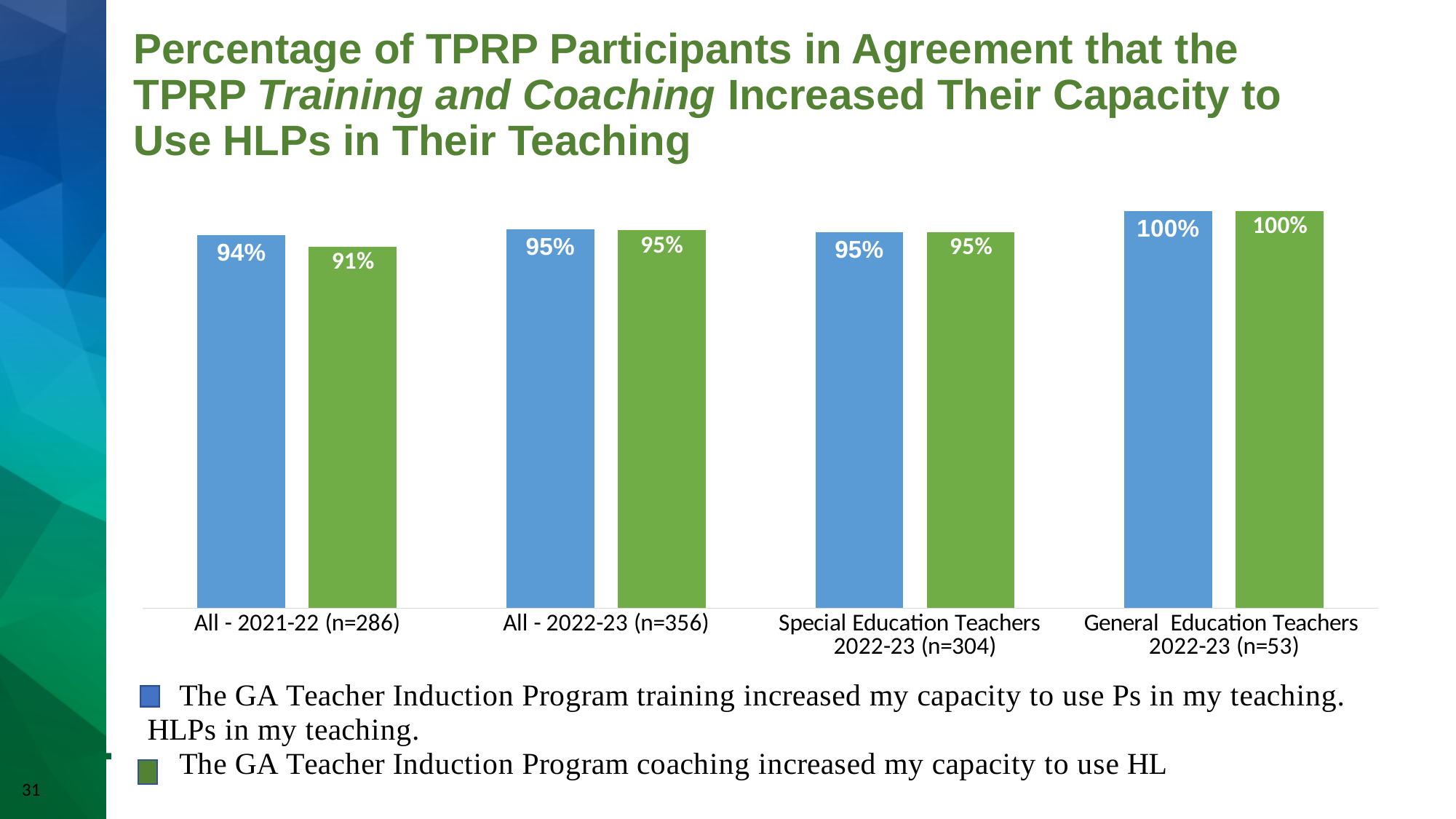
Which category has the lowest coaching percentage? All - 2021-22 (n=286) What type of chart is shown on the slide? Bar chart What is the difference between the training and coaching percentages for All - 2021-22 (n=286)? 3 percentage points What is the coaching value for Special Education Teachers 2022-23 (n=304)? 95% How many series does the legend list? 2 What percentage of All - 2021-22 (n=286) participants agreed that the coaching increased their capacity to use HLPs? 91% For All - 2021-22 (n=286), which is larger: the training percentage or the coaching percentage? Training What is the training value for General Education Teachers 2022-23 (n=53)? 100% Which colour represents the coaching series? Green Which category has the highest coaching percentage? General Education Teachers 2022-23 (n=53) What percentage of All - 2021-22 (n=286) participants agreed that the training increased their capacity to use HLPs? 94% How many categories are shown on the x axis? 4